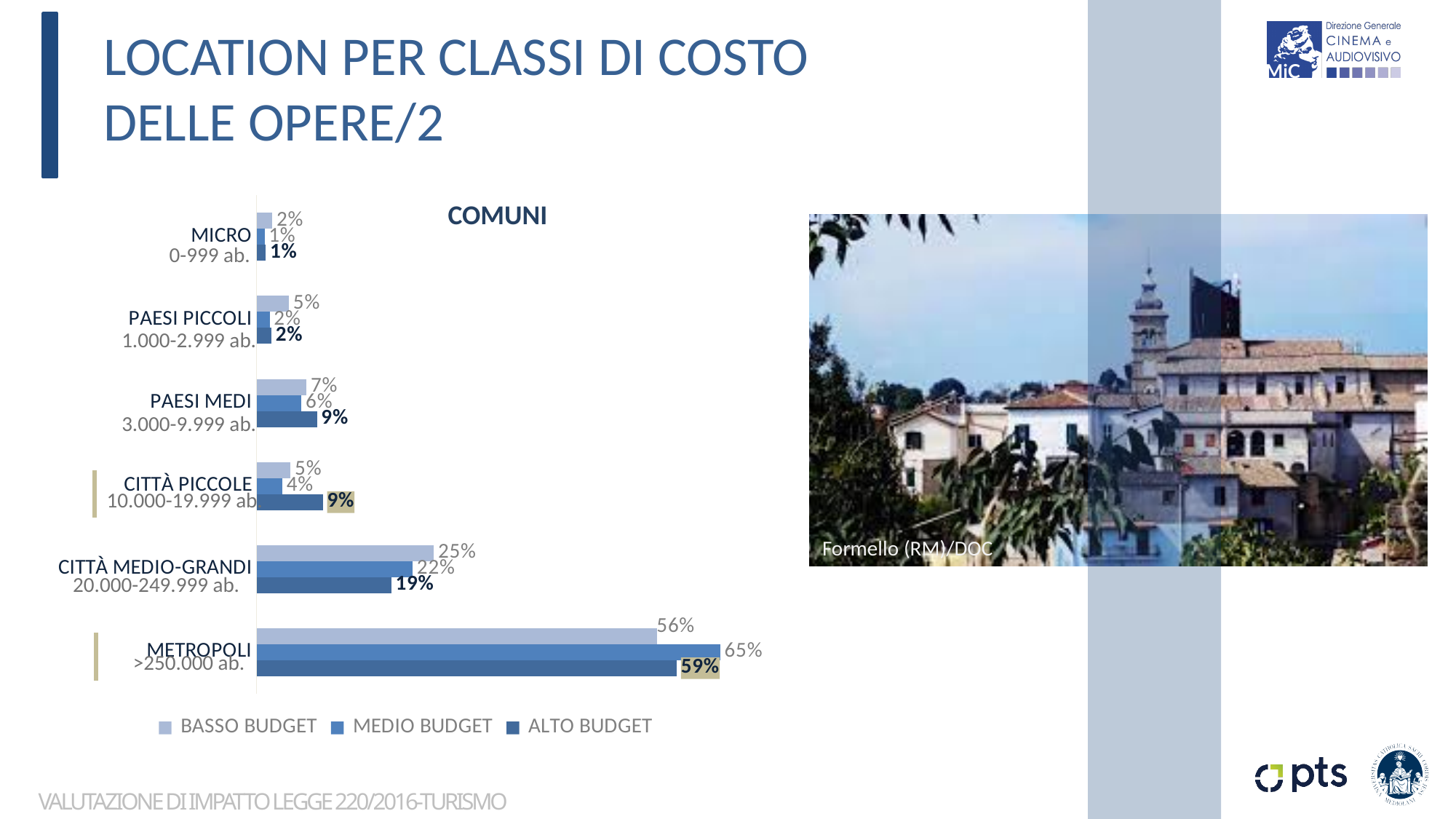
What is the ALTO BUDGET value for CITTÀ MEDIO-GRANDI in the COMUNI chart? 19% What is the BASSO BUDGET value for METROPOLI in the COMUNI chart? 56% In the COMUNI chart, which is larger for CITTÀ PICCOLE: the ALTO BUDGET value or the BASSO BUDGET value? ALTO BUDGET Which category has the lowest BASSO BUDGET value in the COMUNI chart? MICRO What is the MEDIO BUDGET value for METROPOLI in the COMUNI chart? 65% How many categories are shown in the COMUNI chart? 6 How many series does the legend of the COMUNI chart list? 3 What is the difference between the MEDIO BUDGET and BASSO BUDGET values for METROPOLI in the COMUNI chart? 9% What is the BASSO BUDGET value for PAESI MEDI in the COMUNI chart? 7% Which category has the highest MEDIO BUDGET value in the COMUNI chart? METROPOLI What is the difference between the BASSO BUDGET and ALTO BUDGET values for CITTÀ MEDIO-GRANDI in the COMUNI chart? 6% What type of chart is the COMUNI chart? Bar chart